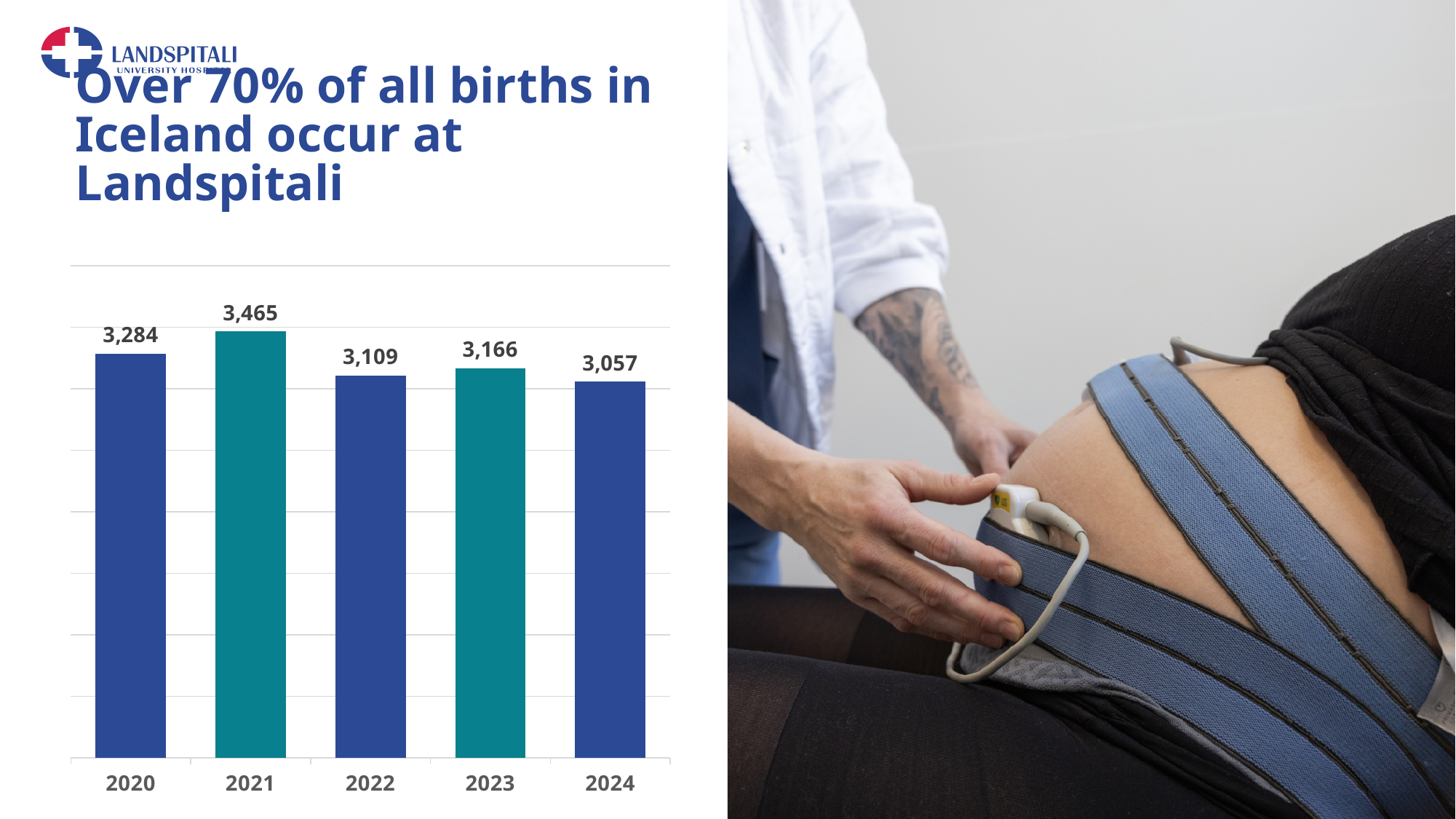
What is the value shown for 2024? 3,057 What kind of chart is shown on the slide? Bar chart Which year has the highest value? 2021 Which year has the lowest value? 2024 Does the value rise or fall from 2021 to 2022? Fall Which is larger, the value for 2020 or the value for 2023? 2020 Which years have bars coloured teal rather than dark blue? 2021 and 2023 What is the difference between the values for 2021 and 2024? 408 What is the difference between the values for 2020 and 2022? 175 What is the value shown for 2021? 3,465 What is the value shown for 2022? 3,109 How many years are shown on the chart? 5